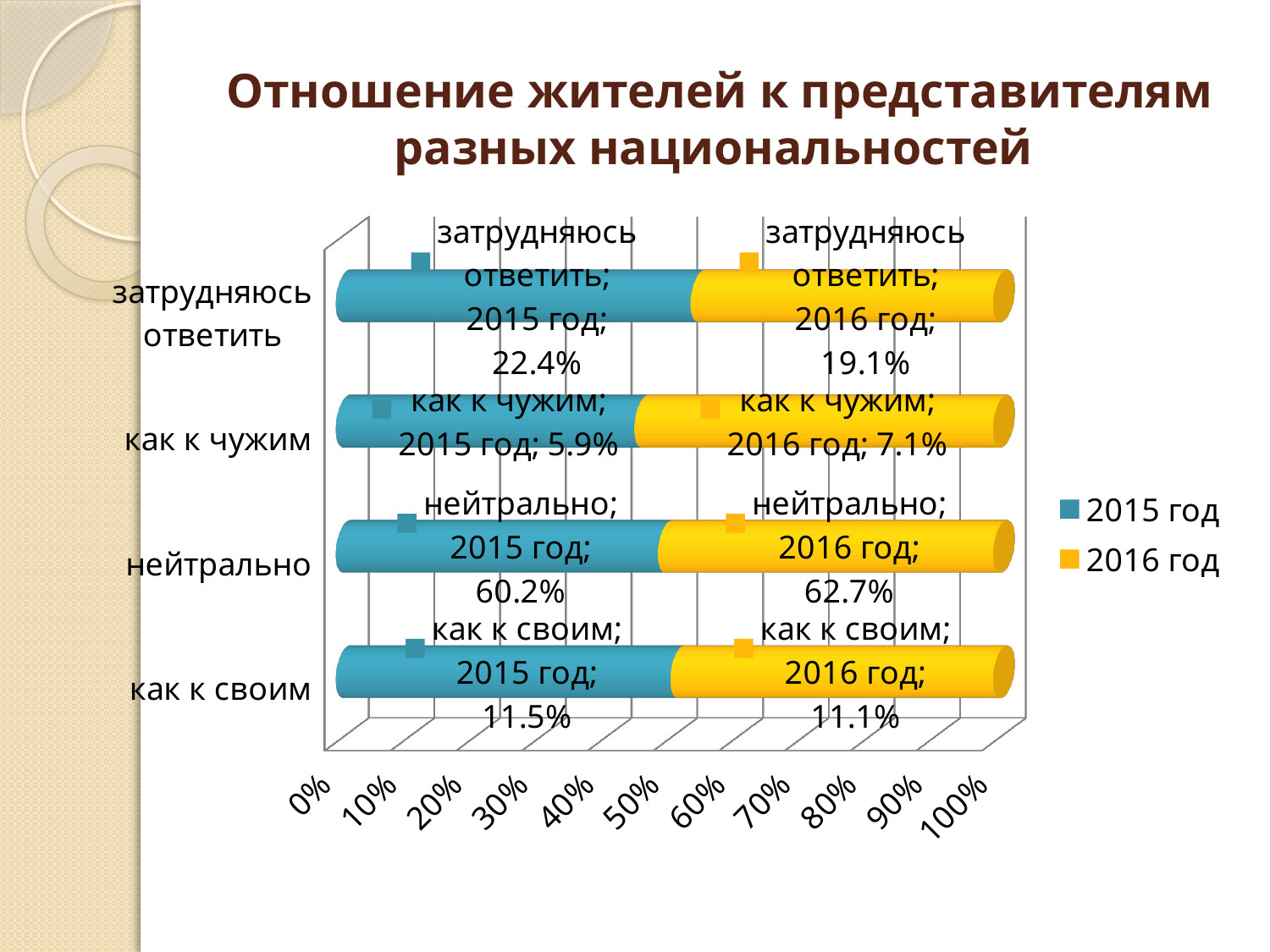
What is the value for «как к своим» in the 2015 год series? 11.5% Which is larger for «как к своим»: the 2015 год value or the 2016 год value? 2015 год How many categories are shown on the chart? 4 What kind of chart is shown on the slide? Bar chart What is the difference between the 2015 год and 2016 год values for «затрудняюсь ответить»? 3.3% What is the value for «затрудняюсь ответить» in the 2016 год series? 19.1% Which category has the highest value in the 2016 год series? нейтрально How many series does the legend list? 2 What is the value for «как к чужим» in the 2016 год series? 7.1% Which is larger for «нейтрально»: the 2015 год value or the 2016 год value? 2016 год What is the value for «нейтрально» in the 2015 год series? 60.2% Which category has the lowest value in the 2015 год series? как к чужим